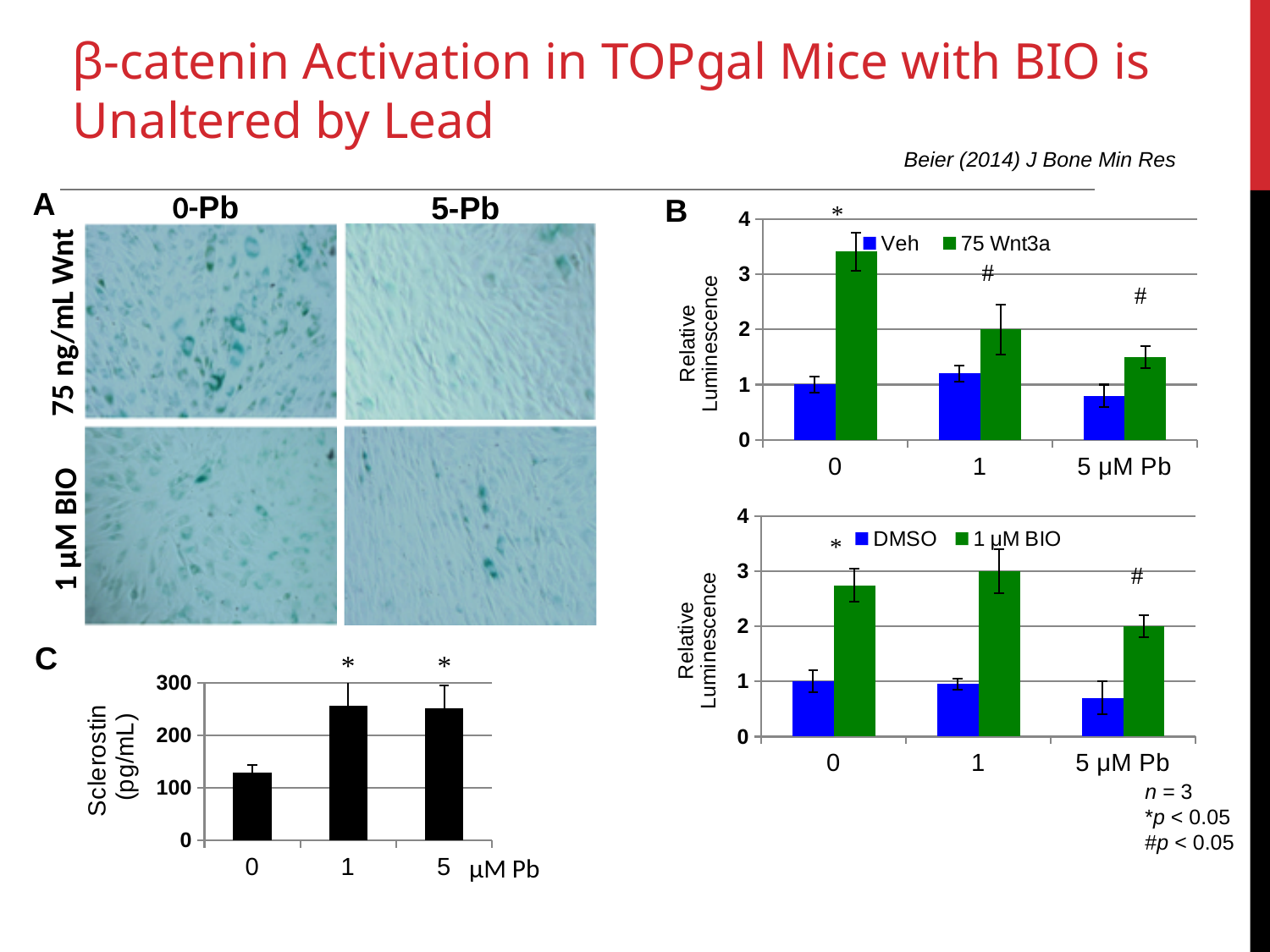
In the bottom chart of panel B, what are the two legend entries? DMSO and 1 µM BIO In the top chart of panel B, at which Pb concentration is the 75 Wnt3a bar highest? 0 What kind of chart is panel C? bar chart In the top chart of panel B, do the 75 Wnt3a values rise or fall as Pb concentration increases? fall In the top chart of panel B, is the 75 Wnt3a value at 0 µM Pb greater or less than 3? greater In the bottom chart of panel B, at which Pb concentration is the DMSO bar lowest? 5 µM Pb In panel C, is the sclerostin value at 0 µM Pb greater or less than 200? less In the top chart of panel B, how many series does the legend list? 2 How many Pb concentrations are plotted in panel C? 3 In the top chart of panel B, what are the two legend entries? Veh and 75 Wnt3a In the bottom chart of panel B, at 0 µM Pb, which is larger: DMSO or 1 µM BIO? 1 µM BIO In the bottom chart of panel B, is the 1 µM BIO value at 5 µM Pb greater or less than 3? less